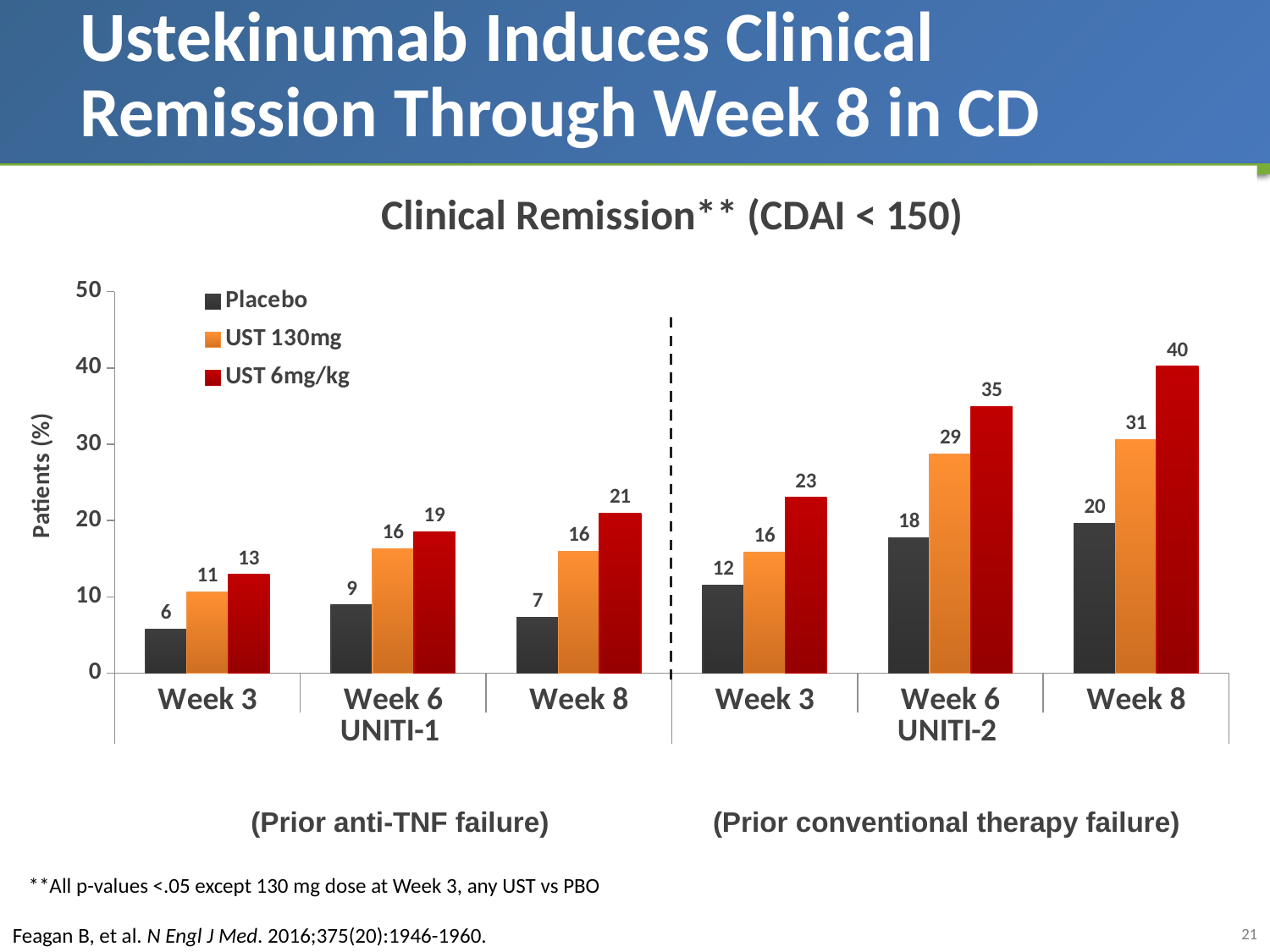
Which series has the lowest value at Week 3 in UNITI-1? Placebo What is the value for Placebo at Week 3 in UNITI-1? 6 What is the difference between UST 6mg/kg and Placebo at Week 8 in UNITI-2? 20 Do the UST 6mg/kg values rise or fall from Week 3 to Week 8 in UNITI-2? Rise How many series does the legend list? 3 What kind of chart is shown on the slide? Bar chart What is the value for UST 6mg/kg at Week 8 in UNITI-2? 40 Which is larger: UST 6mg/kg at Week 8 in UNITI-1 or UST 130mg at Week 8 in UNITI-2? UST 130mg at Week 8 in UNITI-2 What is the title of the chart? Clinical Remission** (CDAI < 150) What is the difference between UST 6mg/kg and UST 130mg at Week 6 in UNITI-1? 3 Which series has the highest value at Week 8 in UNITI-2? UST 6mg/kg What is the value for UST 130mg at Week 6 in UNITI-2? 29